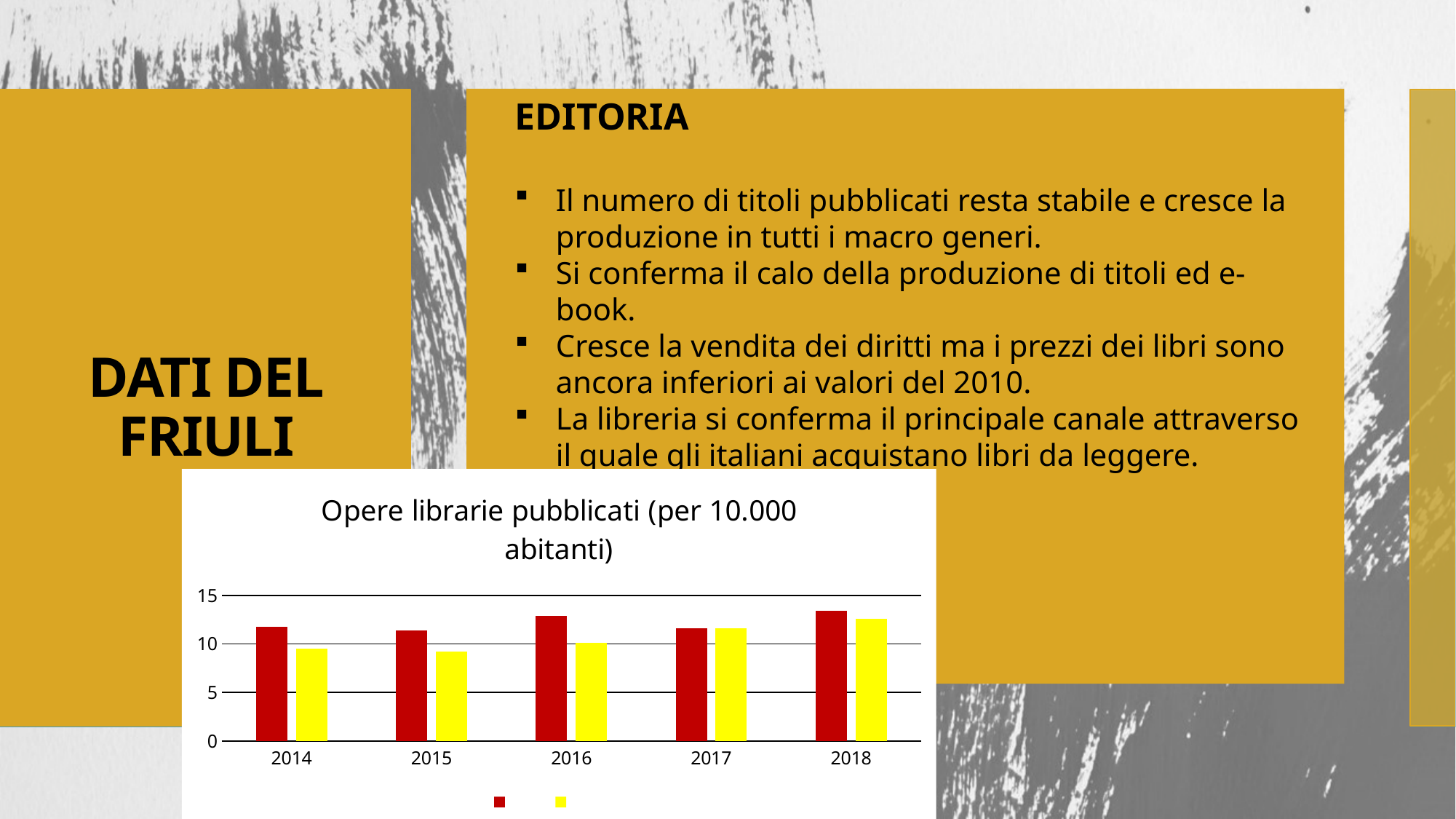
How many series does the chart's legend list? 2 What kind of chart is shown on the slide? bar chart Is the value of the yellow bar for 2018 greater or less than 10? greater In 2014, which bar is larger, the red one or the yellow one? the red one Is the value of the yellow bar for 2014 greater or less than 10? less In which year is the yellow bar the highest? 2018 Is the value of the red bar for 2018 greater or less than 15? less Do the yellow bars generally rise or fall from 2014 to 2018? rise What is the title of the chart? Opere librarie pubblicati (per 10.000 abitanti) How many years are shown on the x axis of the chart? 5